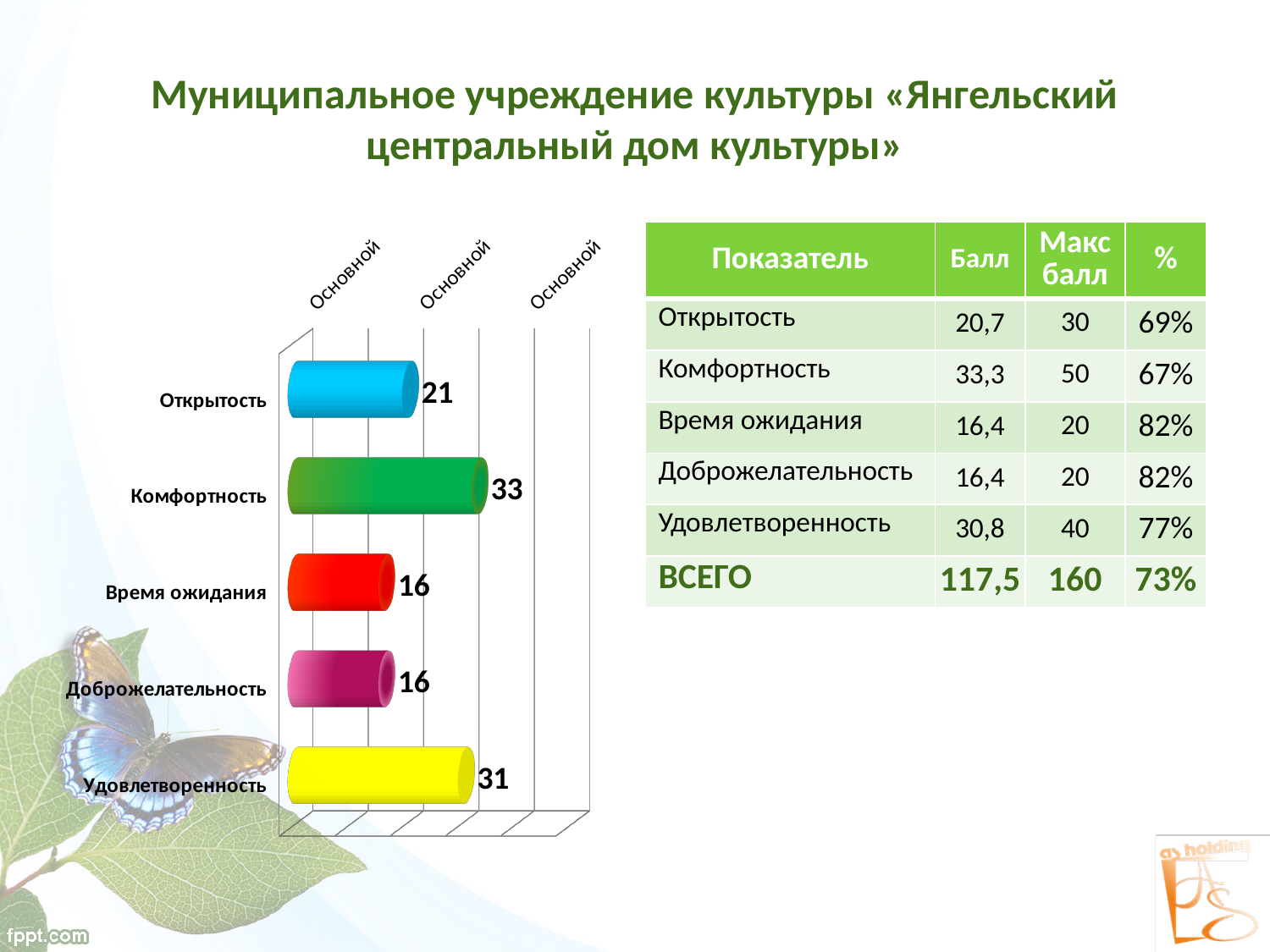
What value does the chart show for Комфортность? 33 What value does the chart show for Открытость? 21 Which is larger in the chart, the value for Открытость or the value for Удовлетворенность? Удовлетворенность What is the difference between the values for Комфортность and Открытость in the chart? 12 What is the difference between the values for Удовлетворенность and Доброжелательность in the chart? 15 What value does the chart show for Удовлетворенность? 31 What kind of chart is shown on the slide? Bar chart What value does the chart show for Время ожидания? 16 How many categories are plotted in the chart? 5 Which two categories in the chart have the same value? Время ожидания and Доброжелательность Which category has the highest value in the chart? Комфортность What colour is the bar for Удовлетворенность in the chart? Yellow